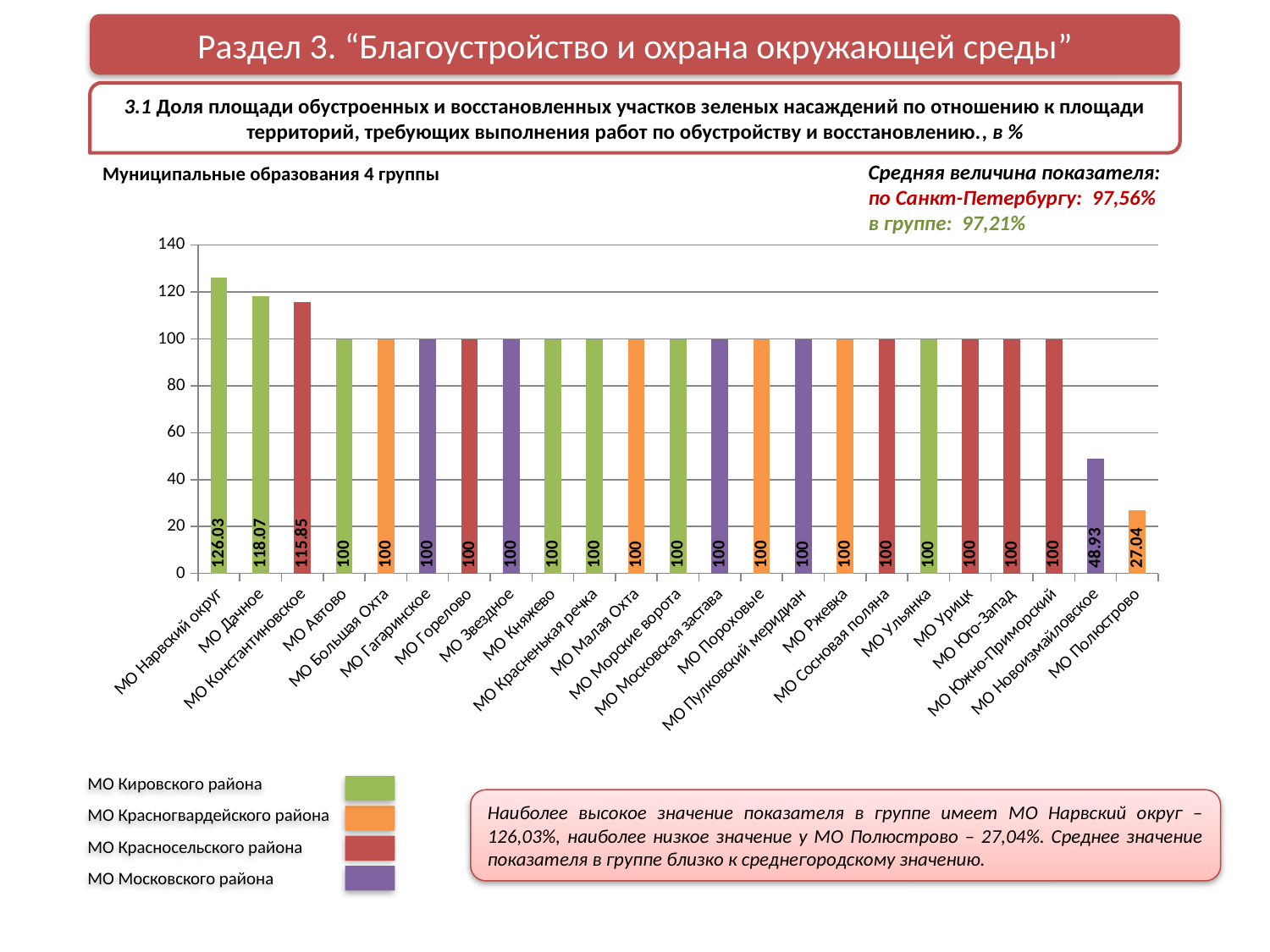
Which category has the highest value? МО Нарвский округ Which is larger, the value for МО Дачное or the value for МО Константиновское? МО Дачное What is the difference between the values for МО Нарвский округ and МО Дачное? 7.96 Which category has the lowest value? МО Полюстрово What is the value for МО Нарвский округ? 126.03 Is the value for МО Полюстрово greater or less than 40? less How many categories are shown on the x axis? 23 What kind of chart is shown on the slide? bar chart What is the difference between the values for МО Новоизмайловское and МО Полюстрово? 21.89 What is the value for МО Новоизмайловское? 48.93 How many entries does the legend list? 4 What is the value for МО Константиновское? 115.85